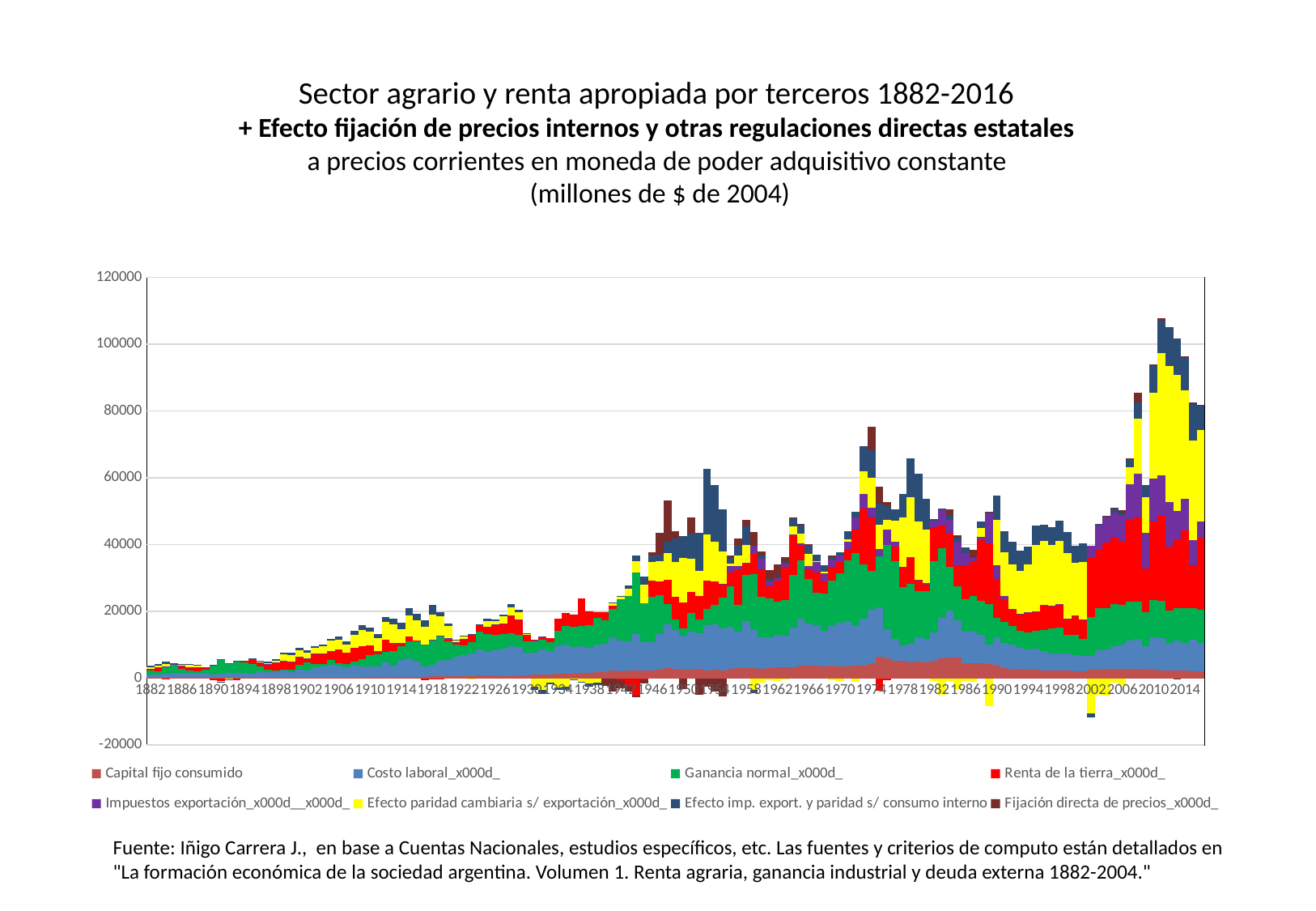
Overall, do the stacked totals rise or fall from 1882 to the 2010s? rise Which series is shown in yellow in the legend? Efecto paridad cambiaria s/ exportación Which series is shown in red in the legend? Renta de la tierra What is the highest value shown on the vertical axis? 120000 Which period has the taller stacked bars: around 1890 or around 2010? around 2010 Is the tallest stacked bar in the chart (around 2011) greater or less than 100000? greater Is the total stacked value for 1898 greater or less than 40000? less What kind of chart is shown on the slide? Stacked bar chart Is the total stacked value for 1882 greater or less than 20000? less How many series does the legend list? 8